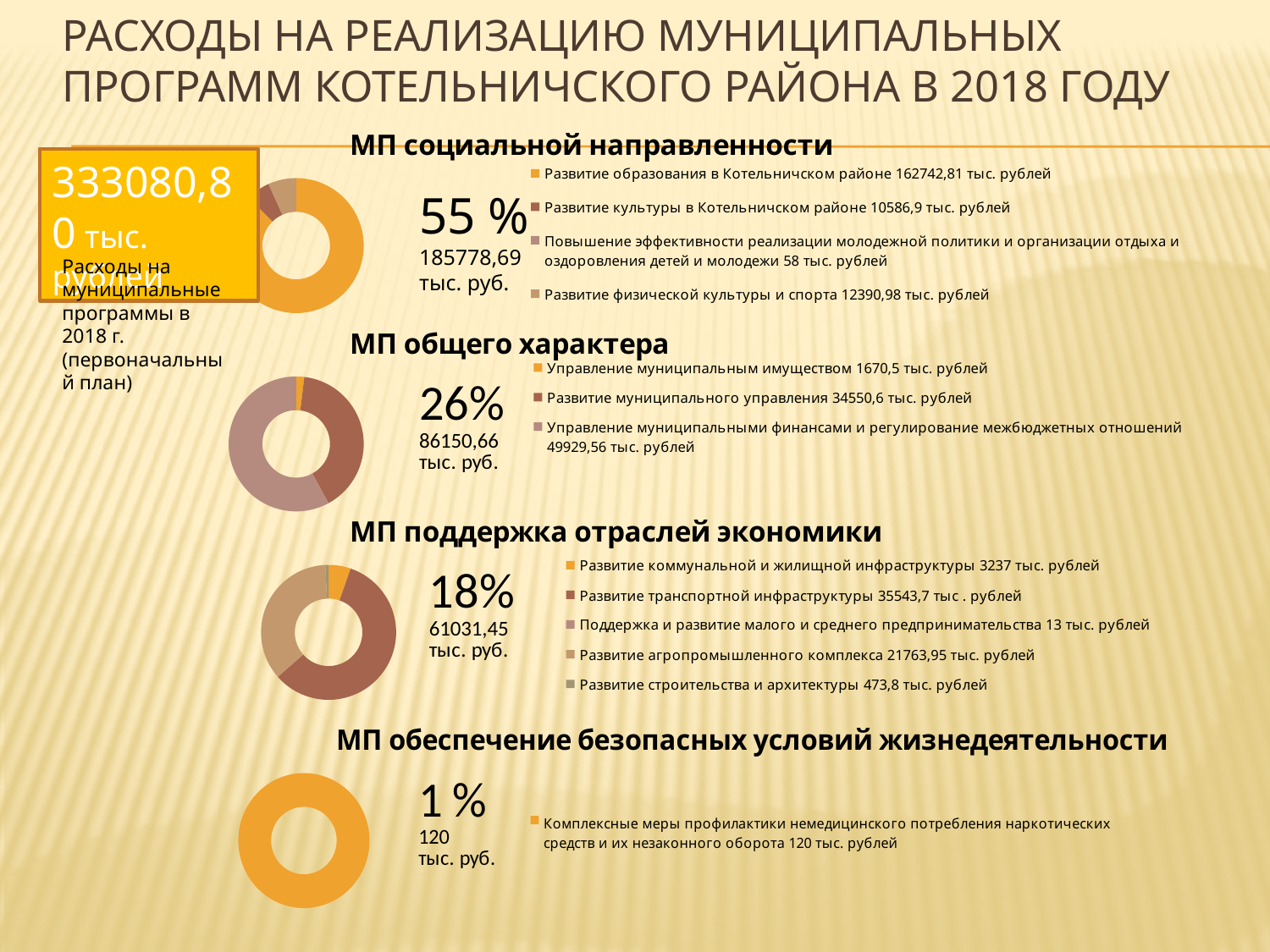
In the "МП поддержка отраслей экономики" chart, how many programs are listed in the legend? 5 In the "МП поддержка отраслей экономики" chart, which is larger: "Развитие транспортной инфраструктуры" or "Развитие агропромышленного комплекса"? Развитие транспортной инфраструктуры In the "МП социальной направленности" chart, how many legend entries (programs) are listed? 4 In the "МП поддержка отраслей экономики" chart, what is the difference between "Развитие коммунальной и жилищной инфраструктуры" (3237) and "Развитие строительства и архитектуры" (473,8)? 2763,2 тыс. рублей In the "МП общего характера" chart, what is the value for "Развитие муниципального управления"? 34550,6 тыс. рублей What is the value for "Комплексные меры профилактики немедицинского потребления наркотических средств и их незаконного оборота" in the "МП обеспечение безопасных условий жизнедеятельности" chart? 120 тыс. рублей In the "МП социальной направленности" chart, which program has the smallest value? Повышение эффективности реализации молодежной политики и организации отдыха и оздоровления детей и молодежи What is the total for "МП общего характера" shown on the slide? 86150,66 тыс. руб. What kind of chart is used for "МП социальной направленности"? Doughnut (pie) chart What share of total expenditure does "МП социальной направленности" account for? 55 % In the "МП социальной направленности" chart, what is the value for "Развитие образования в Котельничском районе"? 162742,81 тыс. рублей In the "МП общего характера" chart, which program has the largest value? Управление муниципальными финансами и регулирование межбюджетных отношений